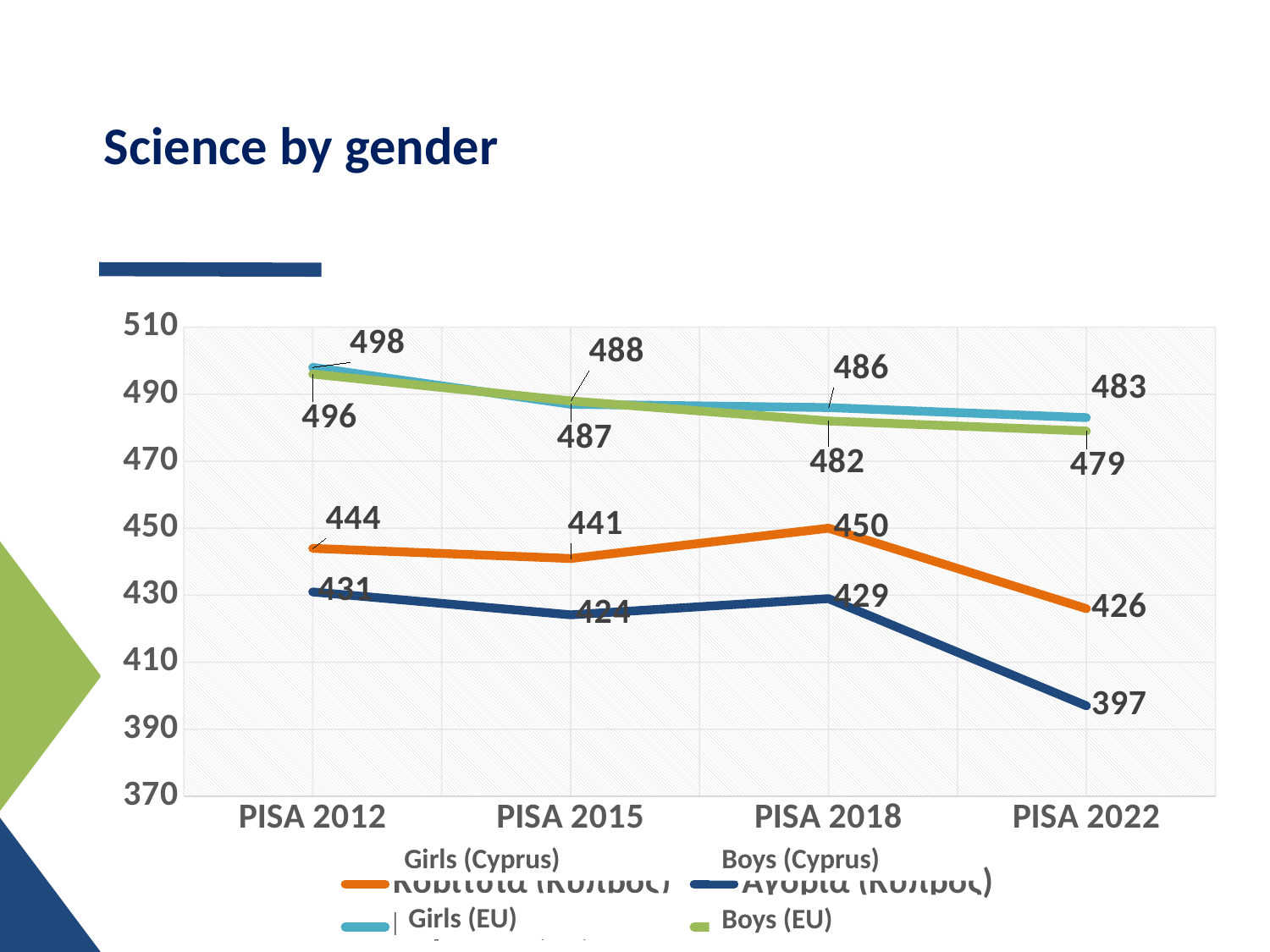
Does the value for Boys (EU) rise or fall from PISA 2012 to PISA 2022? Fall Which is larger in PISA 2012: Girls (EU) or Boys (EU)? Girls (EU) How many series does the legend list? 4 In which PISA cycle is the value for Boys (Cyprus) lowest? PISA 2022 What is the value for Boys (Cyprus) in PISA 2022? 397 What kind of chart is shown on the slide? Line chart What is the value for Girls (EU) in PISA 2012? 498 What is the value for Girls (Cyprus) in PISA 2018? 450 What is the value for Boys (EU) in PISA 2015? 488 How many PISA cycles are shown on the x axis? 4 What is the difference between Girls (Cyprus) and Boys (Cyprus) in PISA 2022? 29 In which PISA cycle is the value for Girls (Cyprus) highest? PISA 2018